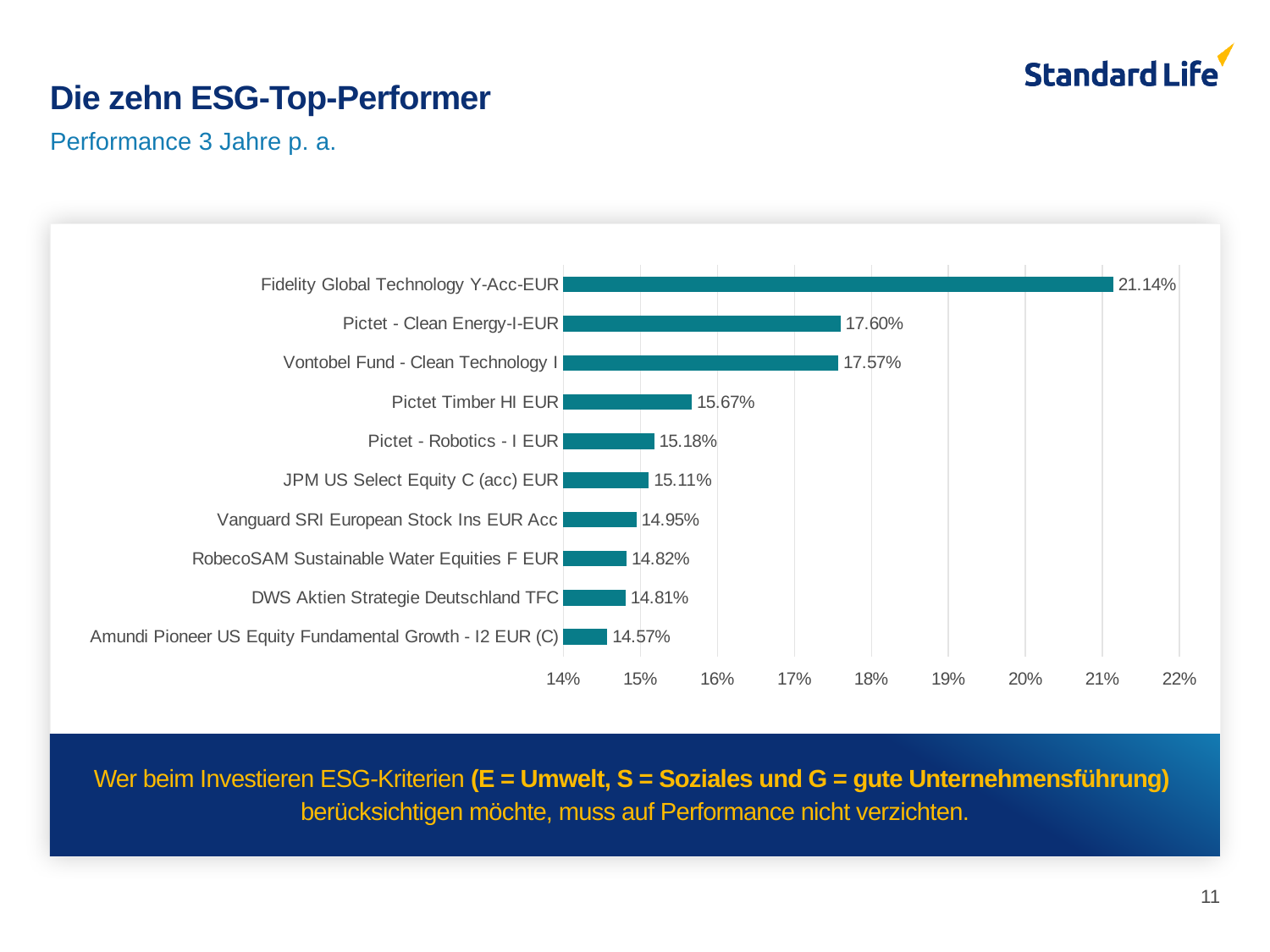
Which has a higher value: Pictet - Robotics - I EUR or Vanguard SRI European Stock Ins EUR Acc? Pictet - Robotics - I EUR What is the value shown for Pictet Timber HI EUR? 15.67% What is the difference between the values for Fidelity Global Technology Y-Acc-EUR and Pictet - Clean Energy-I-EUR? 3.54% Is the value for Vontobel Fund - Clean Technology I greater or less than 17%? greater What kind of chart is shown on the slide? Bar chart Which fund has the highest 3-year performance p.a. in the chart? Fidelity Global Technology Y-Acc-EUR What is the 3-year performance p.a. for Fidelity Global Technology Y-Acc-EUR? 21.14% What is the title of the slide containing the chart? Die zehn ESG-Top-Performer How many funds are shown in the chart? 10 What is the value shown for DWS Aktien Strategie Deutschland TFC? 14.81% What is the difference between the values for Pictet Timber HI EUR and Amundi Pioneer US Equity Fundamental Growth - I2 EUR (C)? 1.10% Which fund has the lowest value in the chart? Amundi Pioneer US Equity Fundamental Growth - I2 EUR (C)